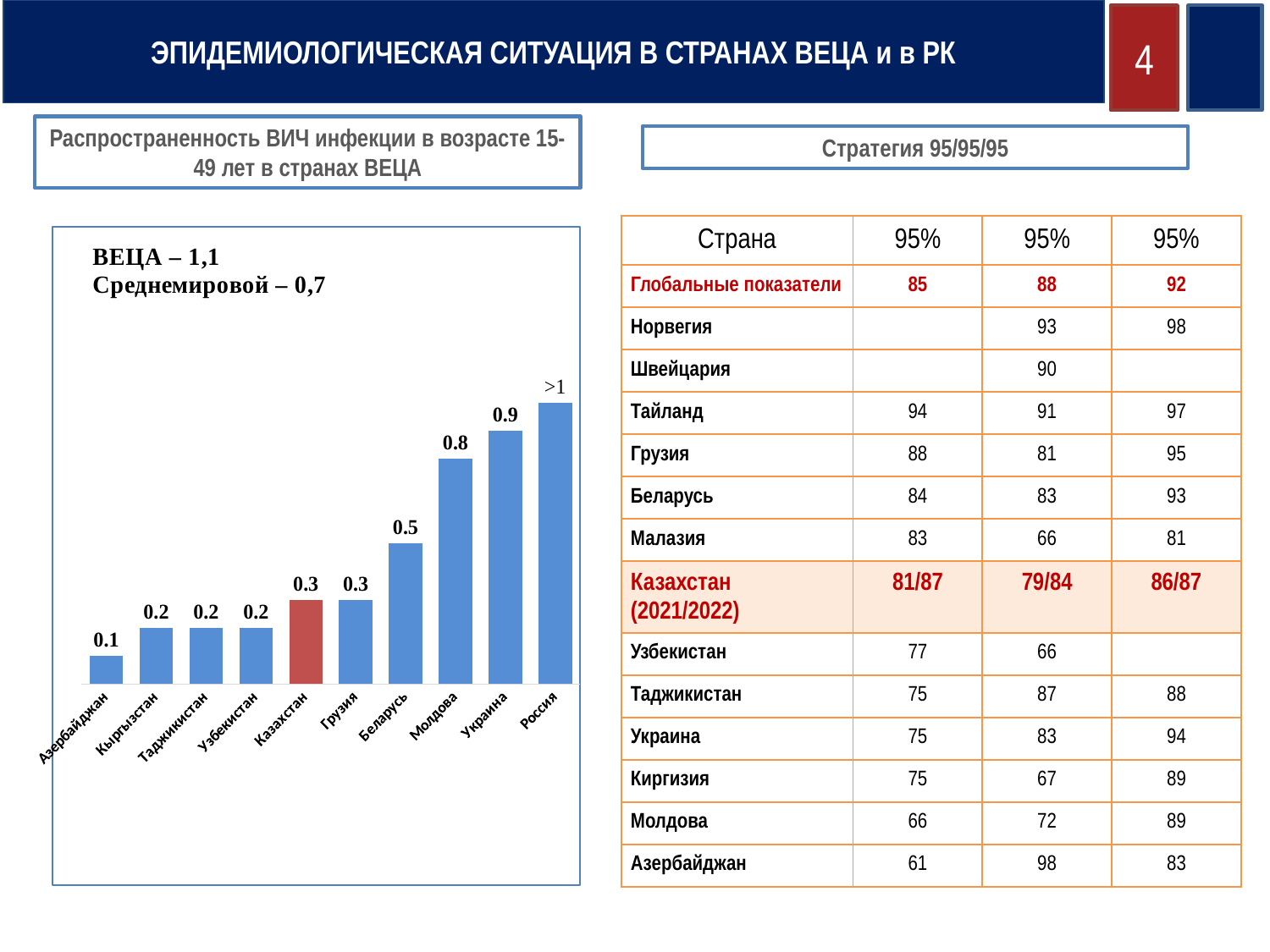
Do the bar values rise or fall from left to right along the x axis? rise What is the value shown for Беларусь in the bar chart? 0.5 How many countries are shown in the bar chart? 10 What is the difference between the values for Украина and Азербайджан in the bar chart? 0.8 What is the value shown for Казахстан in the bar chart? 0.3 What is the value label shown for Россия in the bar chart? >1 What is the value shown for Украина in the bar chart? 0.9 Which has a larger value in the bar chart, Молдова or Беларусь? Молдова Which country has the lowest value in the bar chart? Азербайджан What type of chart is shown on the slide? bar chart Which country's bar is coloured red in the bar chart? Казахстан Which country has the highest bar in the bar chart? Россия